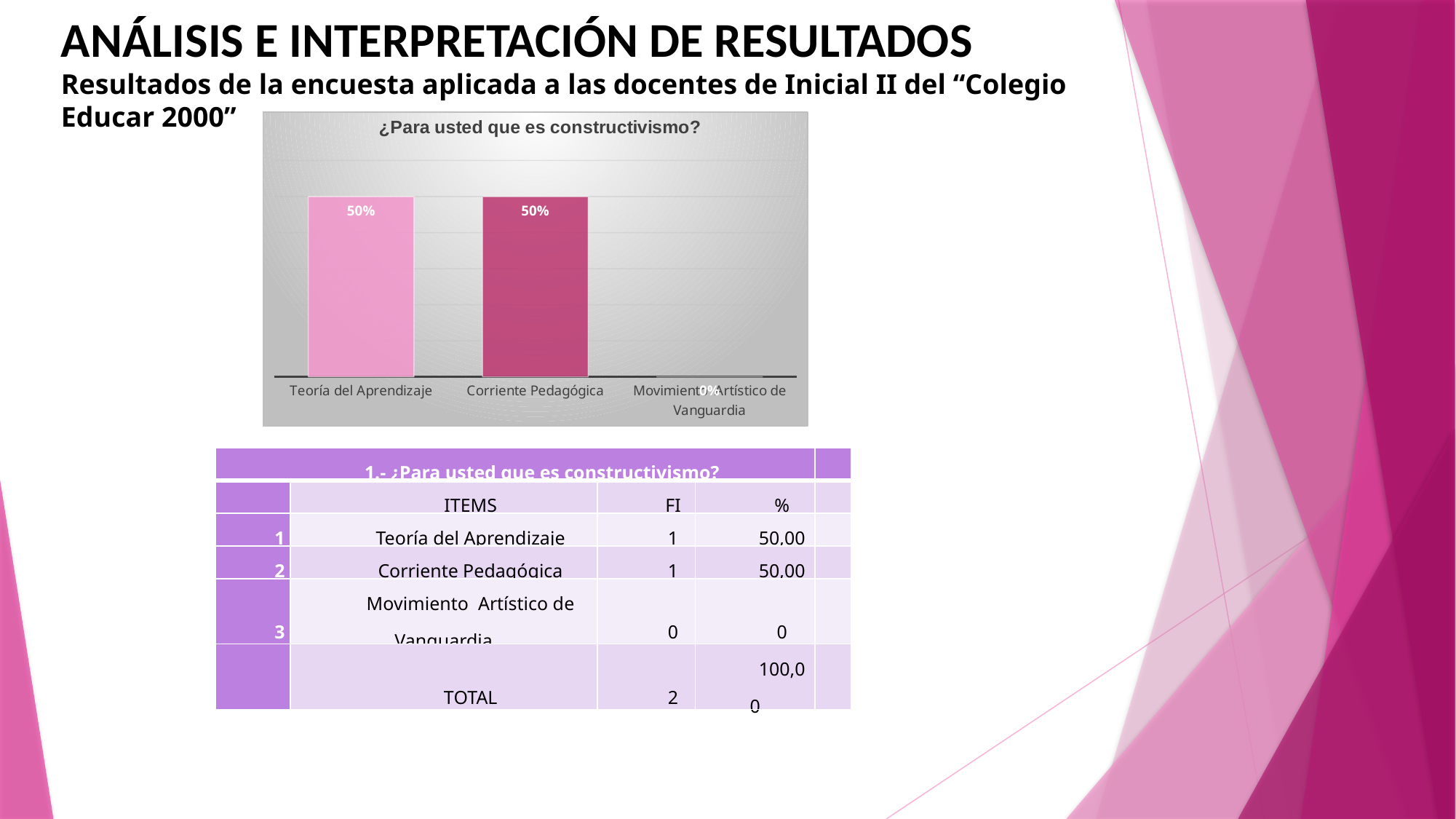
What is the difference between the values for Teoría del Aprendizaje and Corriente Pedagógica? 0% Which is larger, the value for Corriente Pedagógica or the value for Movimiento Artístico de Vanguardia? Corriente Pedagógica What type of chart is shown on the slide? bar chart What is the value for Teoría del Aprendizaje? 50% What is the title of the chart? ¿Para usted que es constructivismo? What is the value for Corriente Pedagógica? 50% Which category has the lowest value? Movimiento Artístico de Vanguardia What is the value for Movimiento Artístico de Vanguardia? 0% What colour is the bar for Corriente Pedagógica? dark pink How many categories are shown on the x axis? 3 What is the difference between the values for Teoría del Aprendizaje and Movimiento Artístico de Vanguardia? 50%